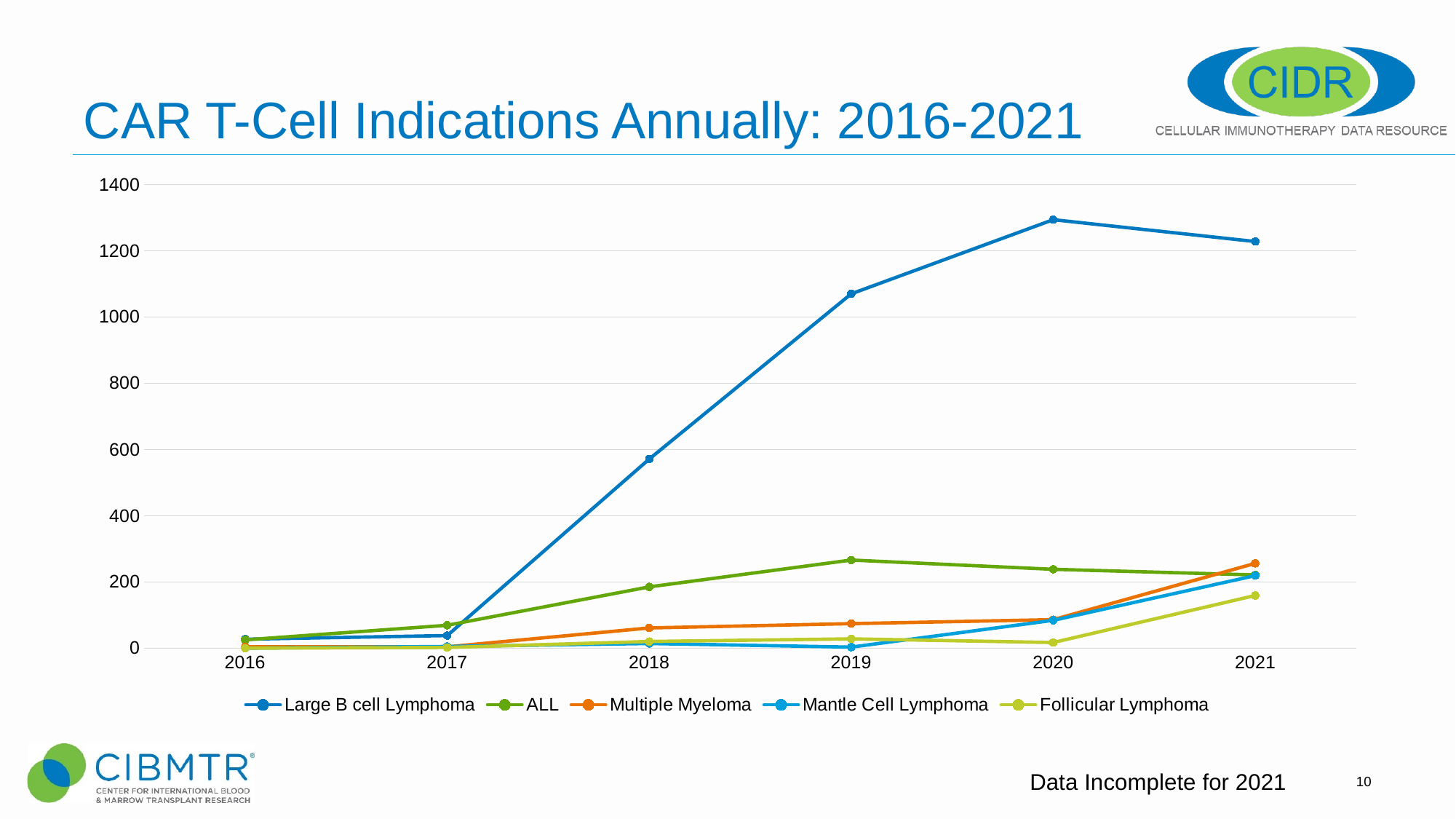
In 2018, which is larger: ALL or Multiple Myeloma? ALL Is the value for ALL in 2019 greater or less than 200? greater In 2021, which is larger: Multiple Myeloma or Follicular Lymphoma? Multiple Myeloma Is the value for Large B cell Lymphoma in 2019 greater or less than 1000? greater What note about the data appears at the bottom of the slide? Data Incomplete for 2021 What kind of chart is shown on the slide? Line chart Which indication has the highest value in 2020? Large B cell Lymphoma In which year does Large B cell Lymphoma reach its highest value? 2020 How many years are shown on the x axis? 6 How many series does the legend list? 5 Is the value for Large B cell Lymphoma in 2018 greater or less than 600? less Does the Large B cell Lymphoma line rise or fall from 2016 to 2020? Rises